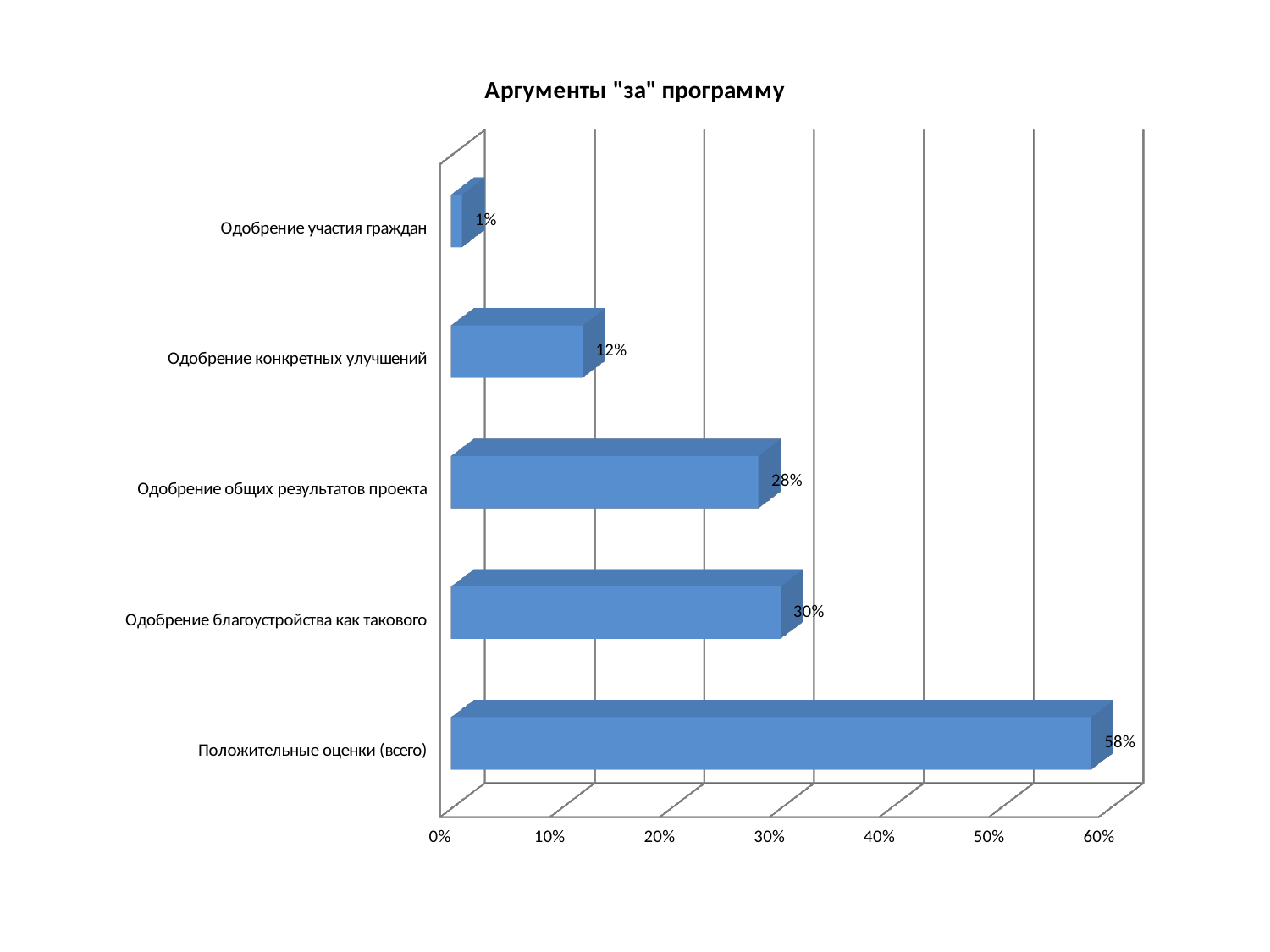
How many categories are shown in the chart? 5 What is the value for "Одобрение конкретных улучшений"? 12% What is the title of the chart? Аргументы "за" программу Which category has the lowest value? Одобрение участия граждан What is the value for "Одобрение благоустройства как такового"? 30% What is the difference between the values for "Положительные оценки (всего)" and "Одобрение благоустройства как такового"? 28% What is the value for "Одобрение участия граждан"? 1% What is the value for "Положительные оценки (всего)"? 58% What kind of chart is shown on the slide? Bar chart Which category has the highest value? Положительные оценки (всего) Which is larger: the value for "Одобрение конкретных улучшений" or the value for "Одобрение общих результатов проекта"? Одобрение общих результатов проекта What is the value for "Одобрение общих результатов проекта"? 28%